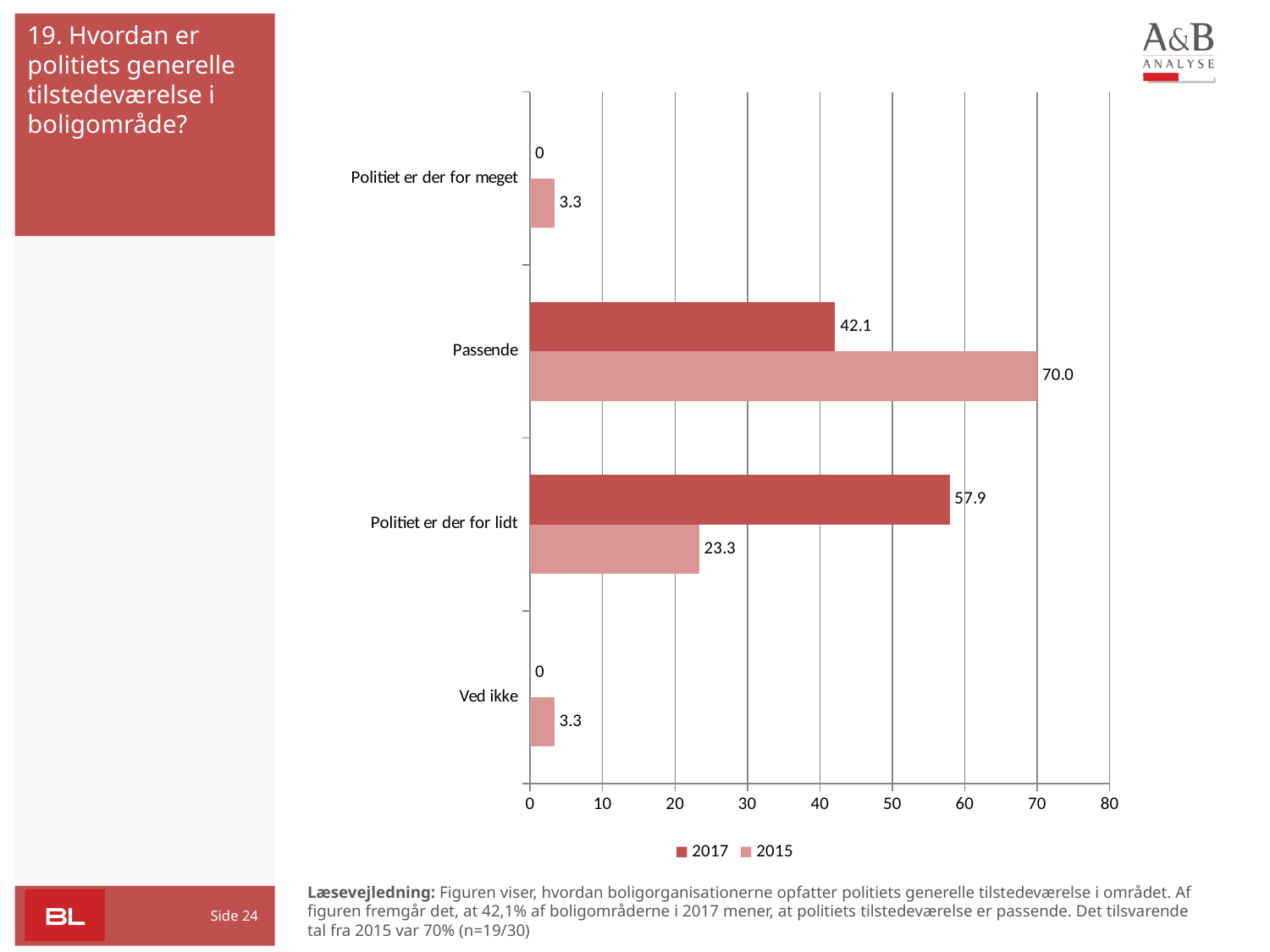
How many categories are shown on the chart? 4 What is the 2015 value for Ved ikke? 3.3 What is the 2017 value for Politiet er der for meget? 0 How many series does the legend list? 2 What is the 2015 value for Politiet er der for lidt? 23.3 For Politiet er der for lidt, which year has the larger value, 2017 or 2015? 2017 What is the 2017 value for Passende? 42.1 What is the difference between the 2015 and 2017 values for Passende? 27.9 Which category has the highest 2015 value? Passende What kind of chart is shown on the slide? Bar chart Which category has the highest 2017 value? Politiet er der for lidt What is the difference between the 2017 and 2015 values for Politiet er der for lidt? 34.6